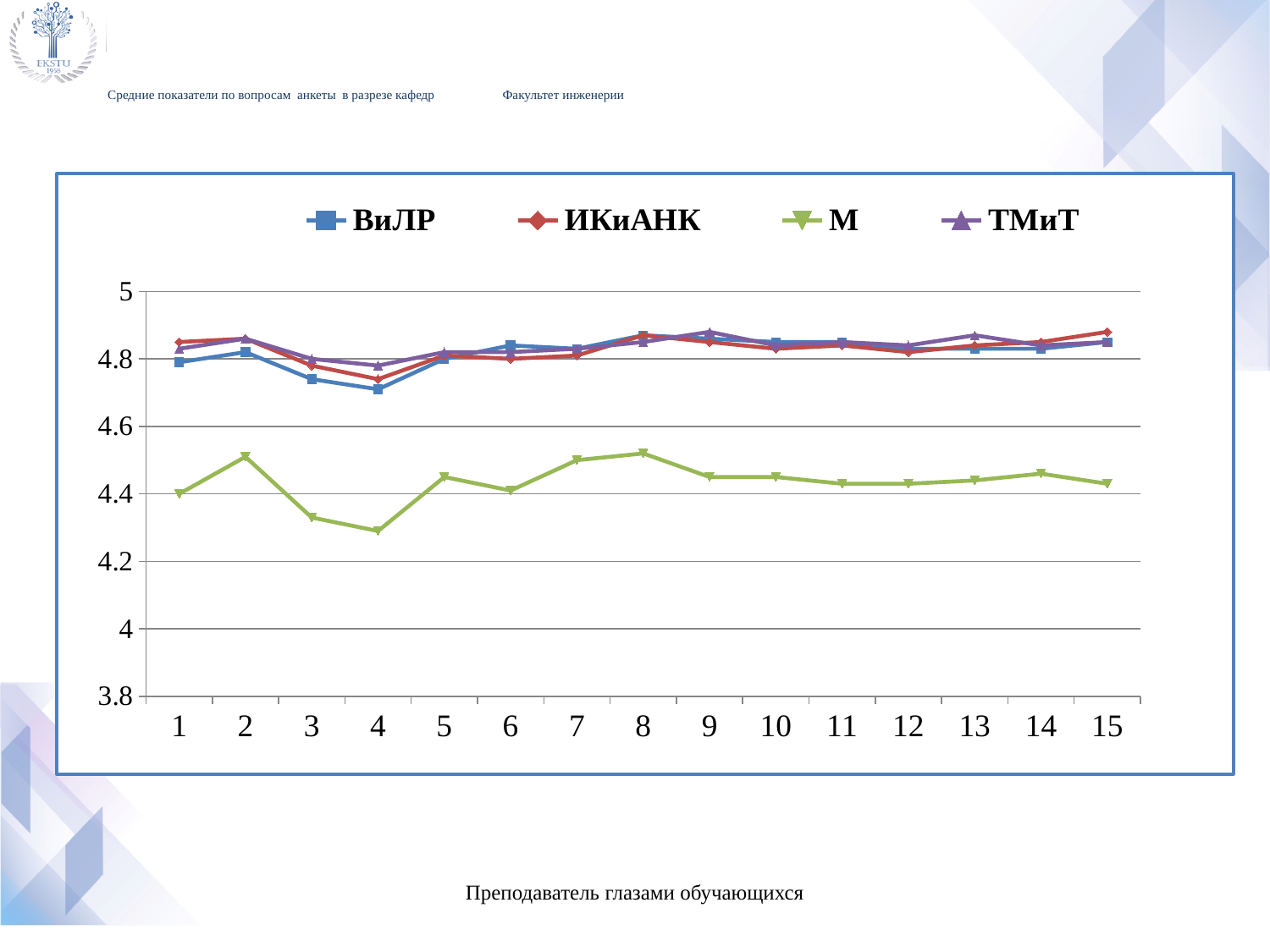
Is the value for М at point 8 greater or less than 4.4? greater Which series has the lowest values across all points? М Is the value for М at point 4 greater or less than 4.4? less How many series does the legend list? 4 How many points are plotted along the x axis for each series? 15 Does the М series rise or fall from point 2 to point 4? fall At point 4, which is larger: ВиЛР or М? ВиЛР Is the value for ВиЛР at point 4 greater or less than 4.8? less At which point does the М series reach its lowest value? 4 What kind of chart is shown on the slide? line chart